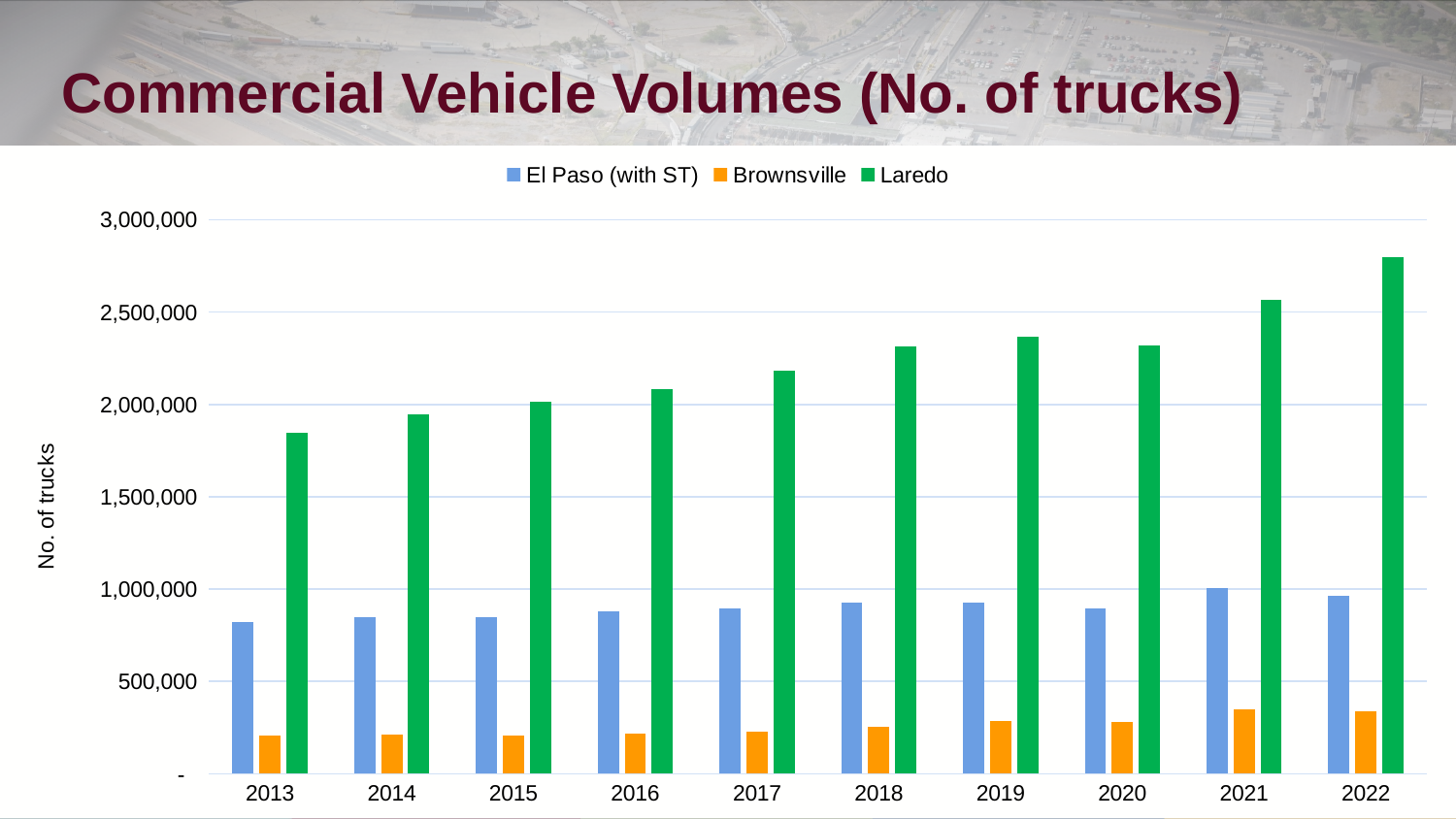
In which year is the Laredo value highest? 2022 Is the value for Brownsville in 2022 greater or less than 500,000? less Is the value for El Paso (with ST) in 2013 greater or less than 1,000,000? less Which series has the lowest value in every year shown? Brownsville How many series does the legend list? 3 Which series has the highest value in every year shown? Laredo How many years are shown on the x axis? 10 Which is larger in 2019: El Paso (with ST) or Laredo? Laredo Is the value for Laredo in 2013 greater or less than 2,000,000? less In which year is the Laredo value lowest? 2013 What kind of chart is shown on the slide? bar chart